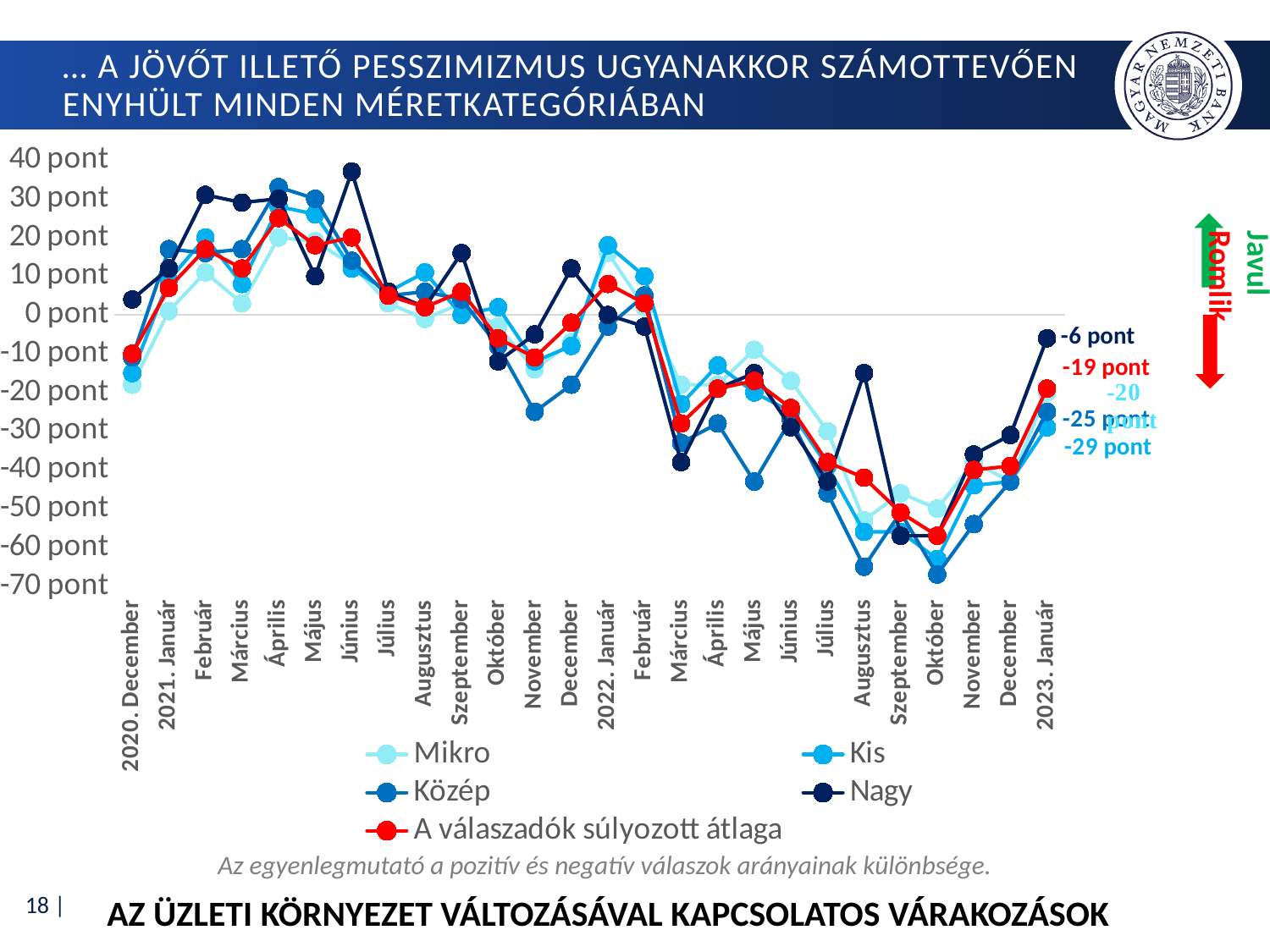
What is the value for Mikro in 2023. Január? -20 pont Is the value for Közép in 2022. Október greater or less than -60 pont? less What kind of chart is shown on the slide? line chart What is the value of A válaszadók súlyozott átlaga in 2023. Január? -19 pont Is the value for Nagy in 2021. Június greater or less than 30 pont? greater How many months are plotted along the x axis? 26 What is the difference between the Nagy value and A válaszadók súlyozott átlaga in 2023. Január? 13 pont Which series has the lowest value in 2023. Január? Kis Which series has the highest value in 2023. Január? Nagy What is the value for Nagy in 2023. Január? -6 pont How many series does the legend list? 5 Does A válaszadók súlyozott átlaga rise or fall from 2022. Október to 2023. Január? rise